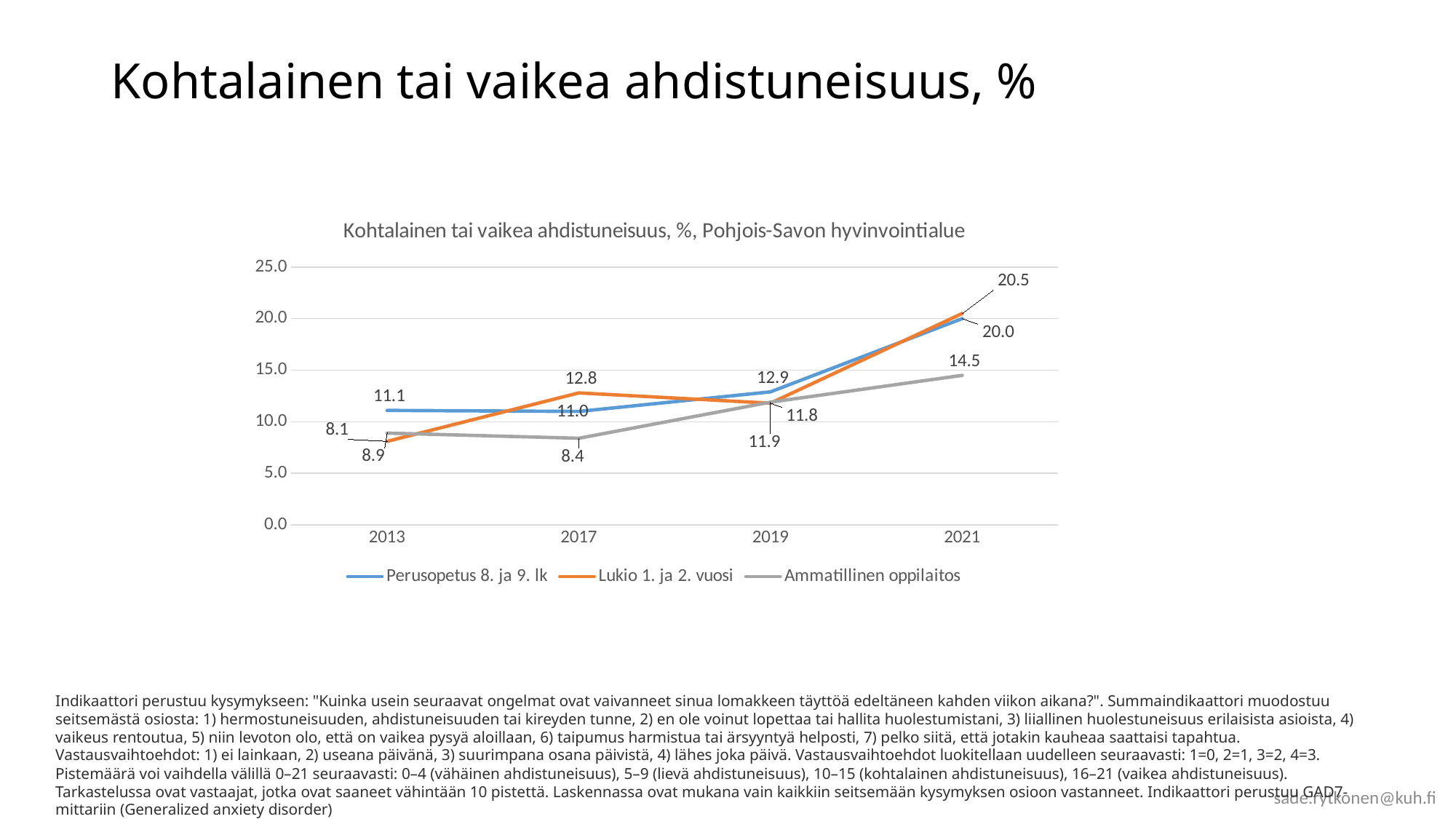
Does the Ammatillinen oppilaitos line rise or fall from 2017 to 2021? Rise How many years are shown on the x axis? 4 What is the value for Perusopetus 8. ja 9. lk in 2019? 12.9 What is the difference between Lukio 1. ja 2. vuosi and Ammatillinen oppilaitos in 2021? 6.0 What is the value for Lukio 1. ja 2. vuosi in 2021? 20.5 Which series has the highest value in 2021? Lukio 1. ja 2. vuosi How many series does the legend list? 3 What is the value for Ammatillinen oppilaitos in 2017? 8.4 What is the value for Ammatillinen oppilaitos in 2021? 14.5 What is the value for Lukio 1. ja 2. vuosi in 2017? 12.8 What is the value for Perusopetus 8. ja 9. lk in 2013? 11.1 What kind of chart is shown on the slide? Line chart